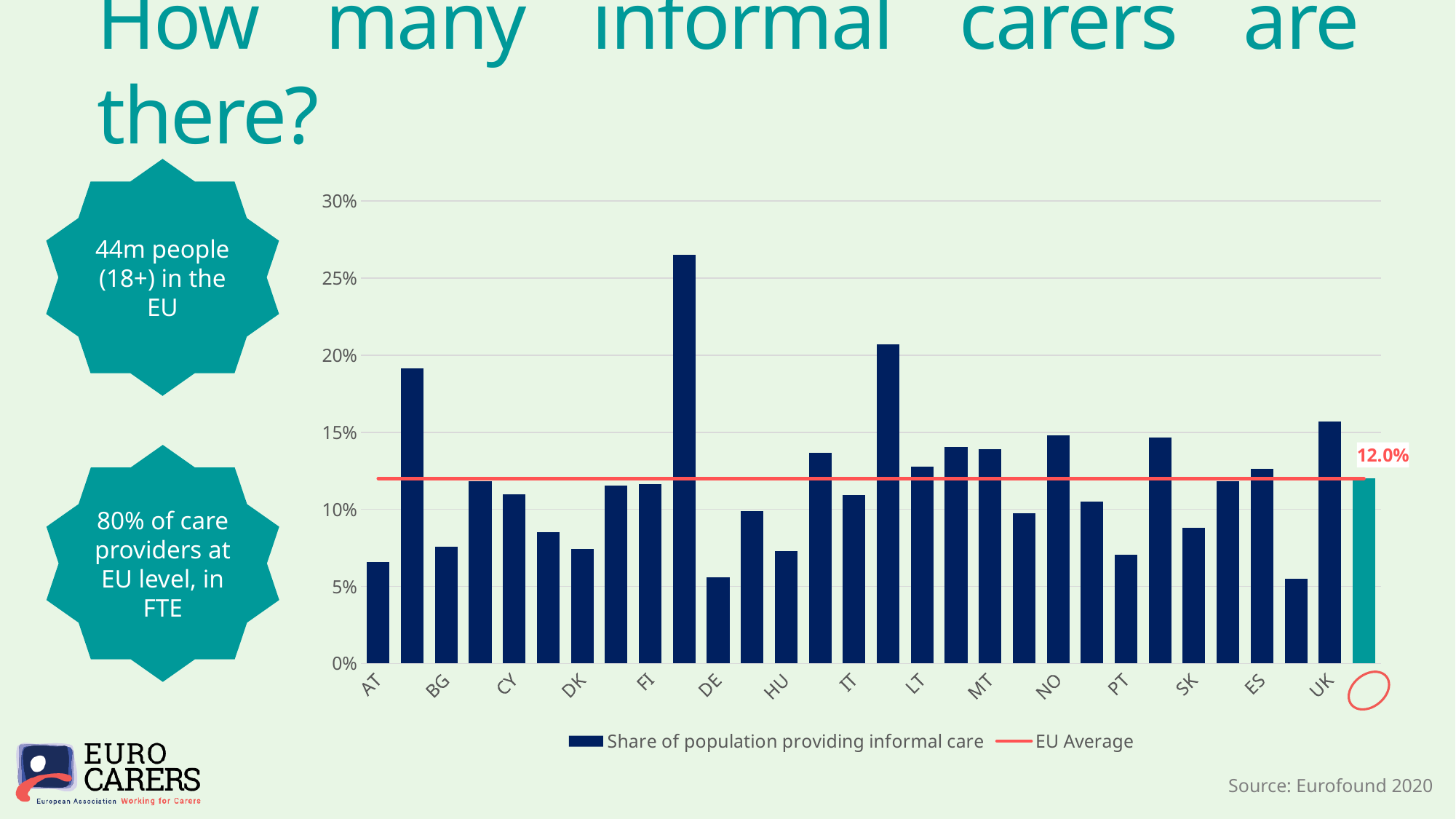
Is the value for UK greater or less than 10%? greater What source is cited for the chart? Eurofound 2020 Is the value for AT greater or less than 10%? less What is the name of the series shown as dark blue bars in the legend? Share of population providing informal care How many series does the chart legend list? 2 Is the value for PT greater or less than 10%? less Which has a larger share of population providing informal care, DE or NO? NO Which has a larger share of population providing informal care, UK or AT? UK What is the EU Average value labelled on the chart? 12.0% What kind of chart is shown on the slide? combination bar and line chart